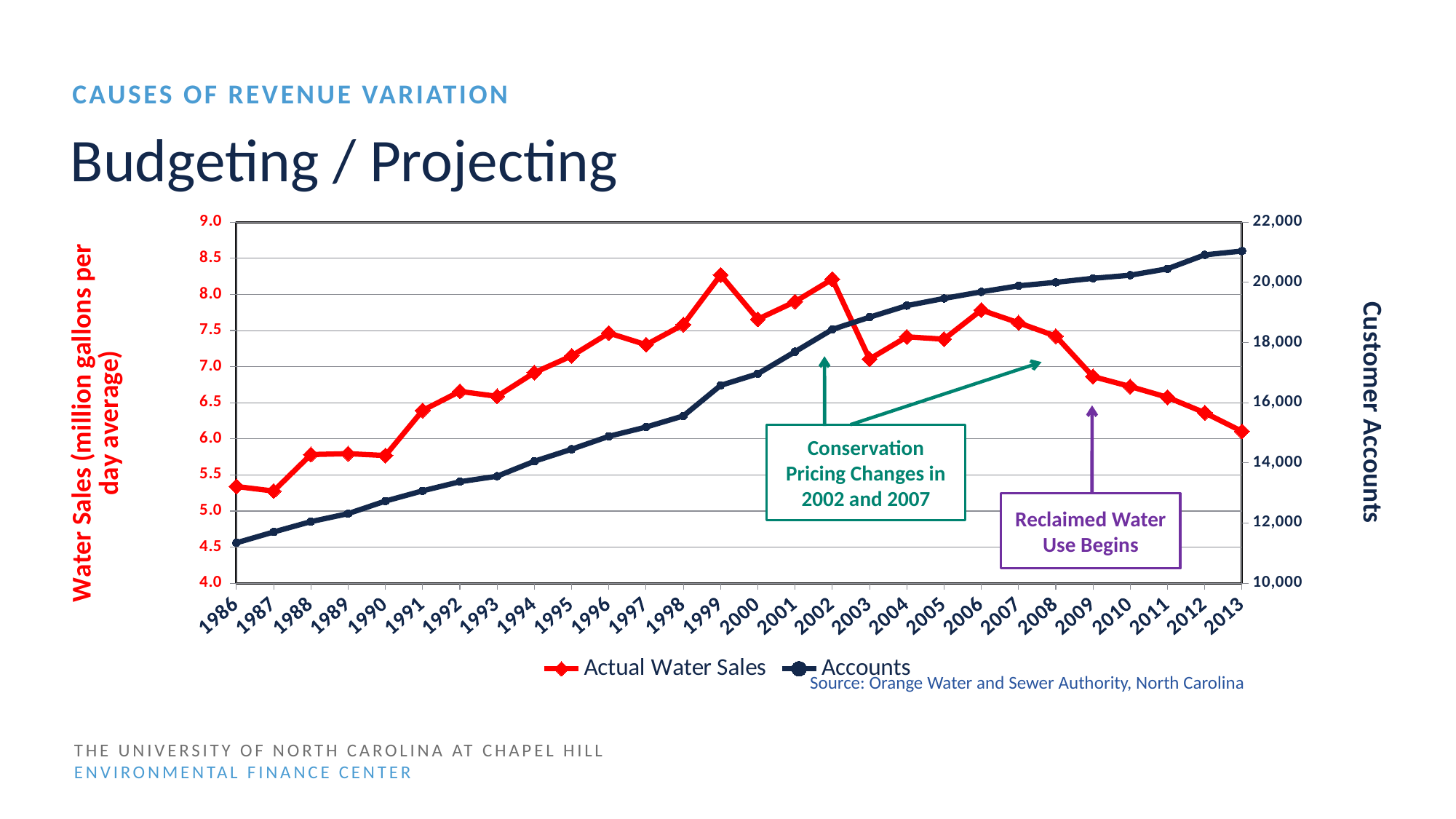
Is the Accounts value for 1986 greater or less than 12,000? less Which year has the larger Actual Water Sales value, 1999 or 2003? 1999 How many series does the legend list? 2 Is the Actual Water Sales value for 1999 greater or less than 8.0? greater How many years are plotted along the x axis? 28 Is the Actual Water Sales value for 2013 greater or less than 6.5? less Which year has the lowest value for Accounts? 1986 Do the Accounts values rise or fall from 1986 to 2013? Rise Which year has the highest value for Accounts? 2013 What is the label on the right-hand vertical axis? Customer Accounts What kind of chart is shown on the slide? Line chart